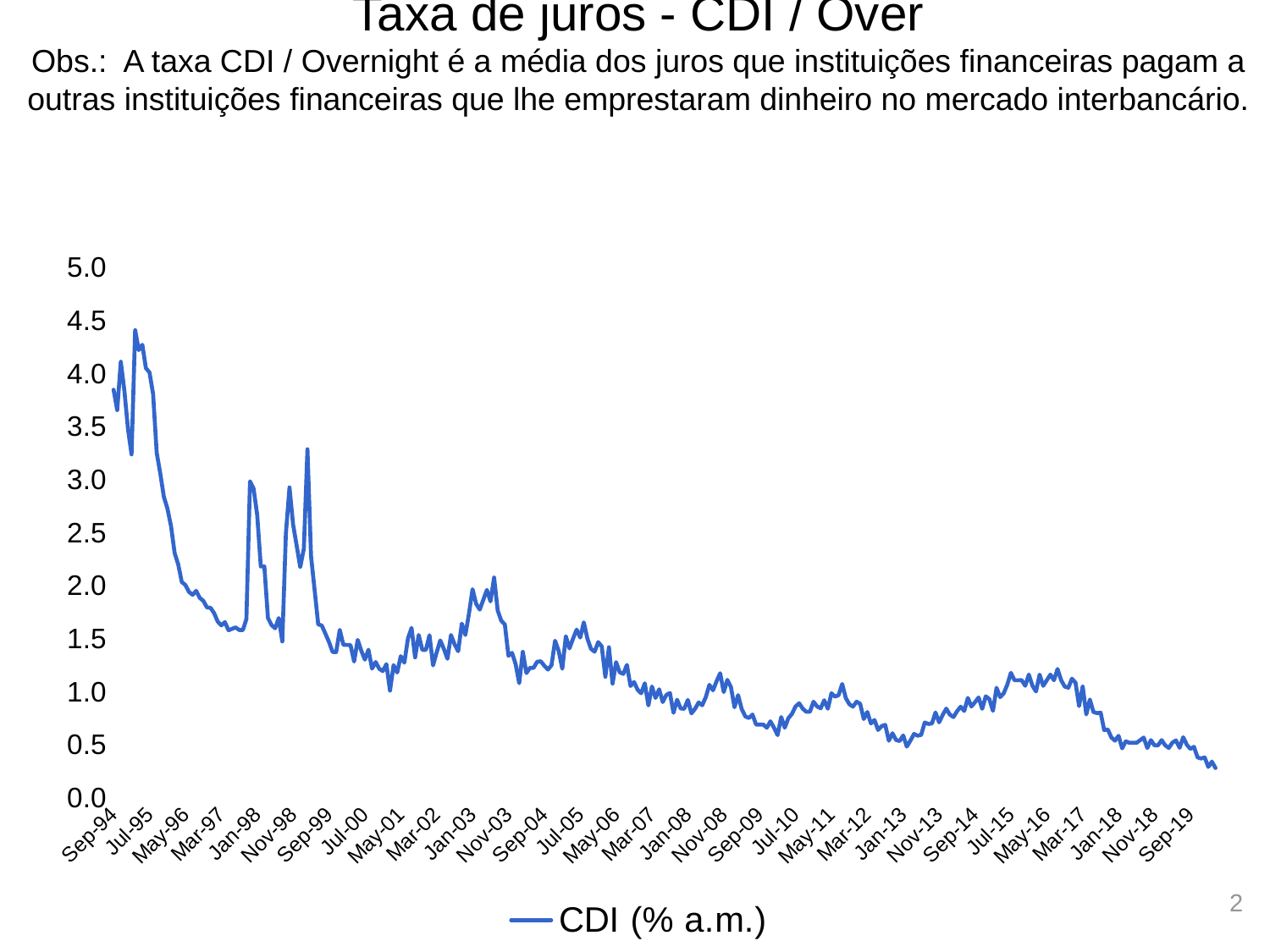
Is the value for Jul-00 greater or less than 2.0? less What is the series name shown in the legend? CDI (% a.m.) Is the value for Jul-15 greater or less than 0.5? greater How many date labels are shown on the x axis? 31 Is the value for Jan-13 greater or less than 1.0? less Which is larger, the value for Sep-94 or the value for Sep-19? Sep-94 How many series does the legend list? 1 Overall, does the CDI rate rise or fall from Sep-94 to Sep-19? fall What kind of chart is shown on the slide? line chart What is the title of the chart? Taxa de juros - CDI / Over